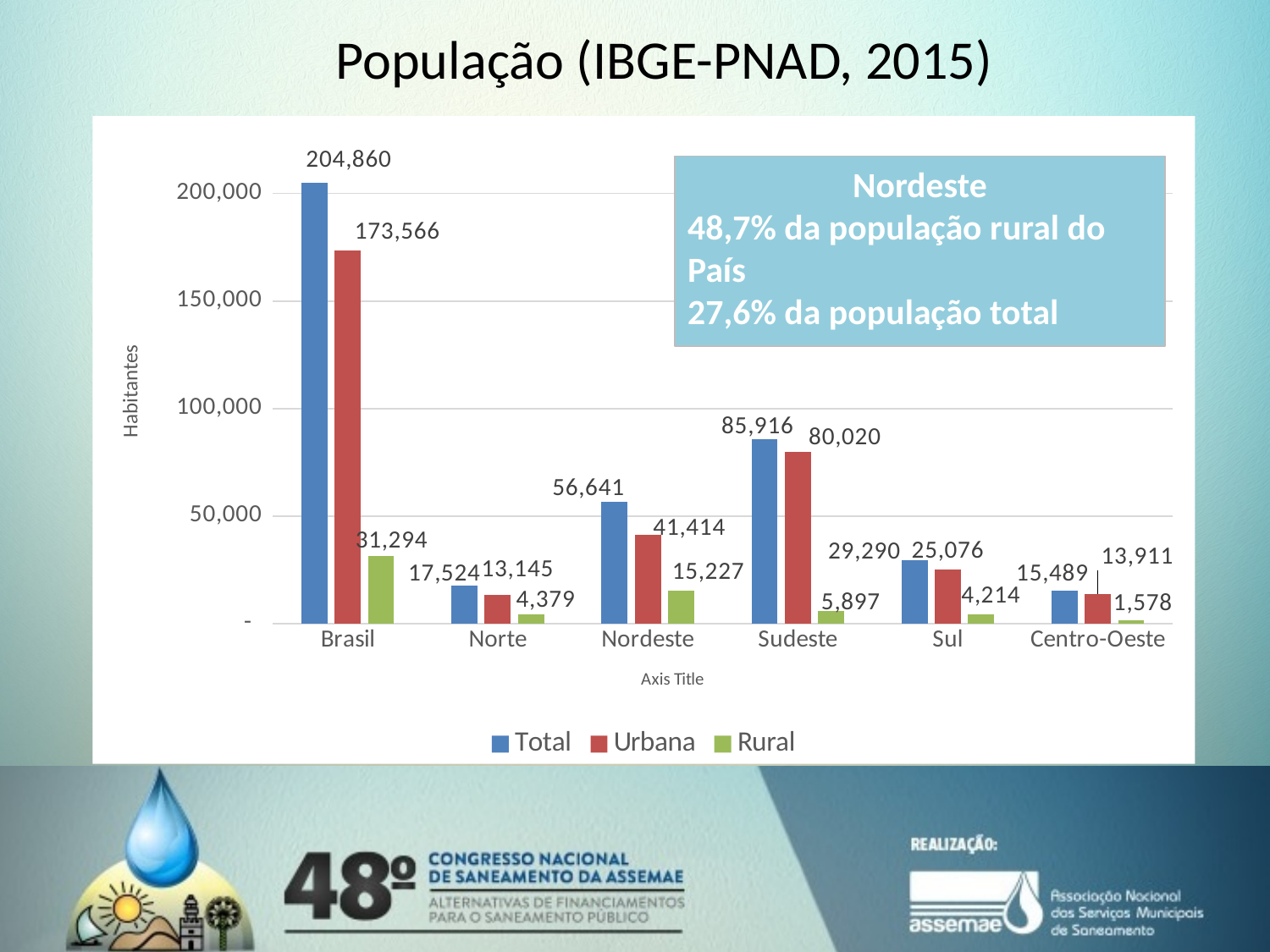
What is the Rural value shown for Sudeste? 5,897 Is the Total value for Nordeste greater or less than 50,000? greater Excluding Brasil, which region has the highest Total population? Sudeste What is the Total value shown for Centro-Oeste? 15,489 What is the Urbana value shown for Nordeste? 41,414 Which category has the lowest Rural value? Centro-Oeste How many categories are shown on the x axis? 6 How many series does the legend list? 3 What is the difference between the Total and Urbana values for Sudeste? 5,896 Which is larger, the Rural value for Nordeste or the Rural value for Norte? Nordeste What is the Total population value shown for Brasil? 204,860 What kind of chart is shown on the slide? Bar chart